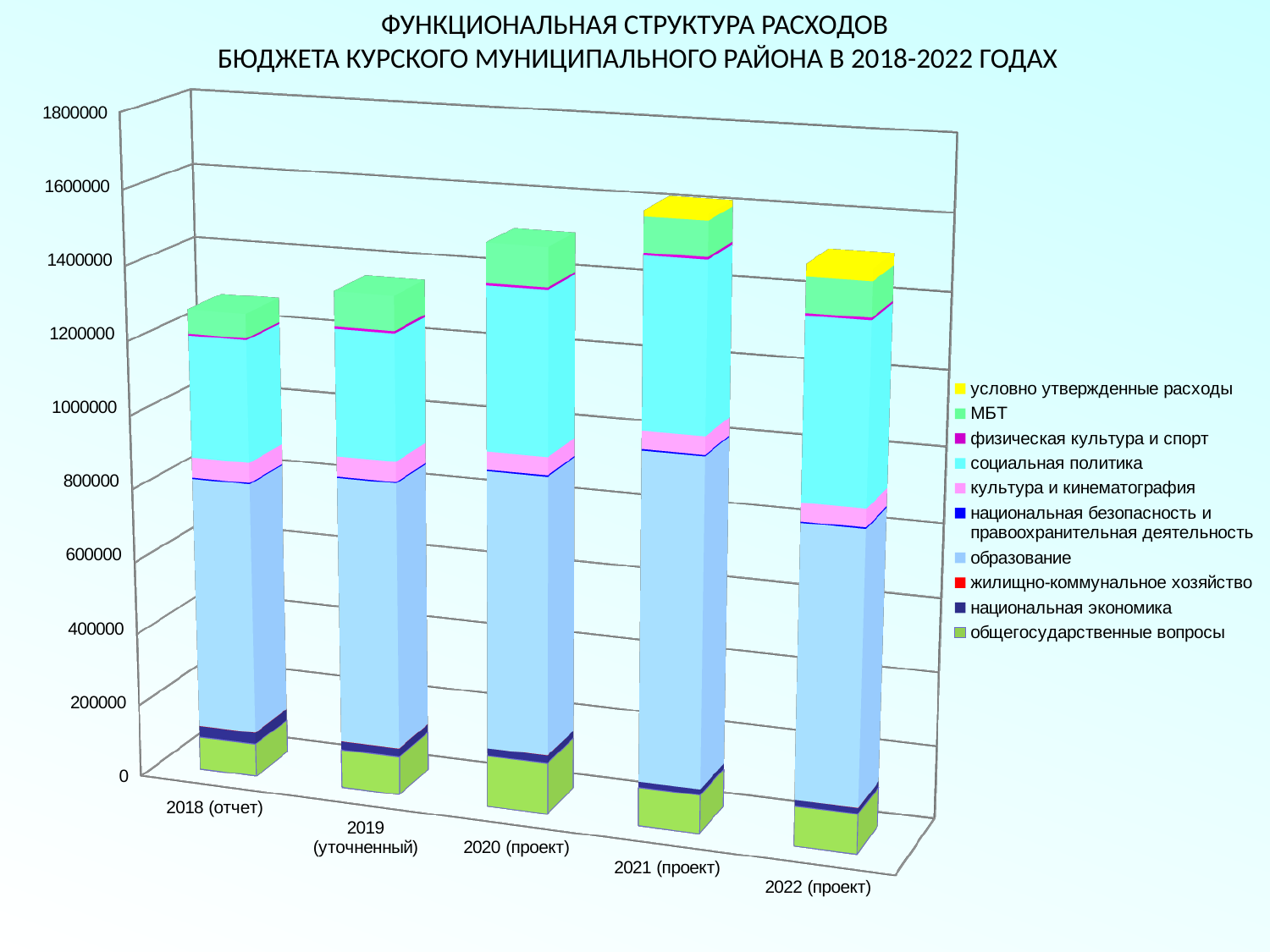
Which series forms the largest segment in every bar? образование How many series does the legend list? 10 Do the total bar heights rise or fall from 2018 (отчет) to 2021 (проект)? rise Is the total for 2018 (отчет) greater or less than 1600000? less How many years (categories) are shown on the x axis? 5 Is the total for 2021 (проект) greater or less than 1000000? greater What kind of chart is shown on the slide? stacked bar chart Which year has the shortest stacked bar (lowest total expenditure)? 2018 (отчет) Which bar is taller: 2021 (проект) or 2022 (проект)? 2021 (проект) Which bar is taller: 2019 (уточненный) or 2020 (проект)? 2020 (проект) Which year has the tallest stacked bar (highest total expenditure)? 2021 (проект) Which series is shown in yellow in the legend? условно утвержденные расходы